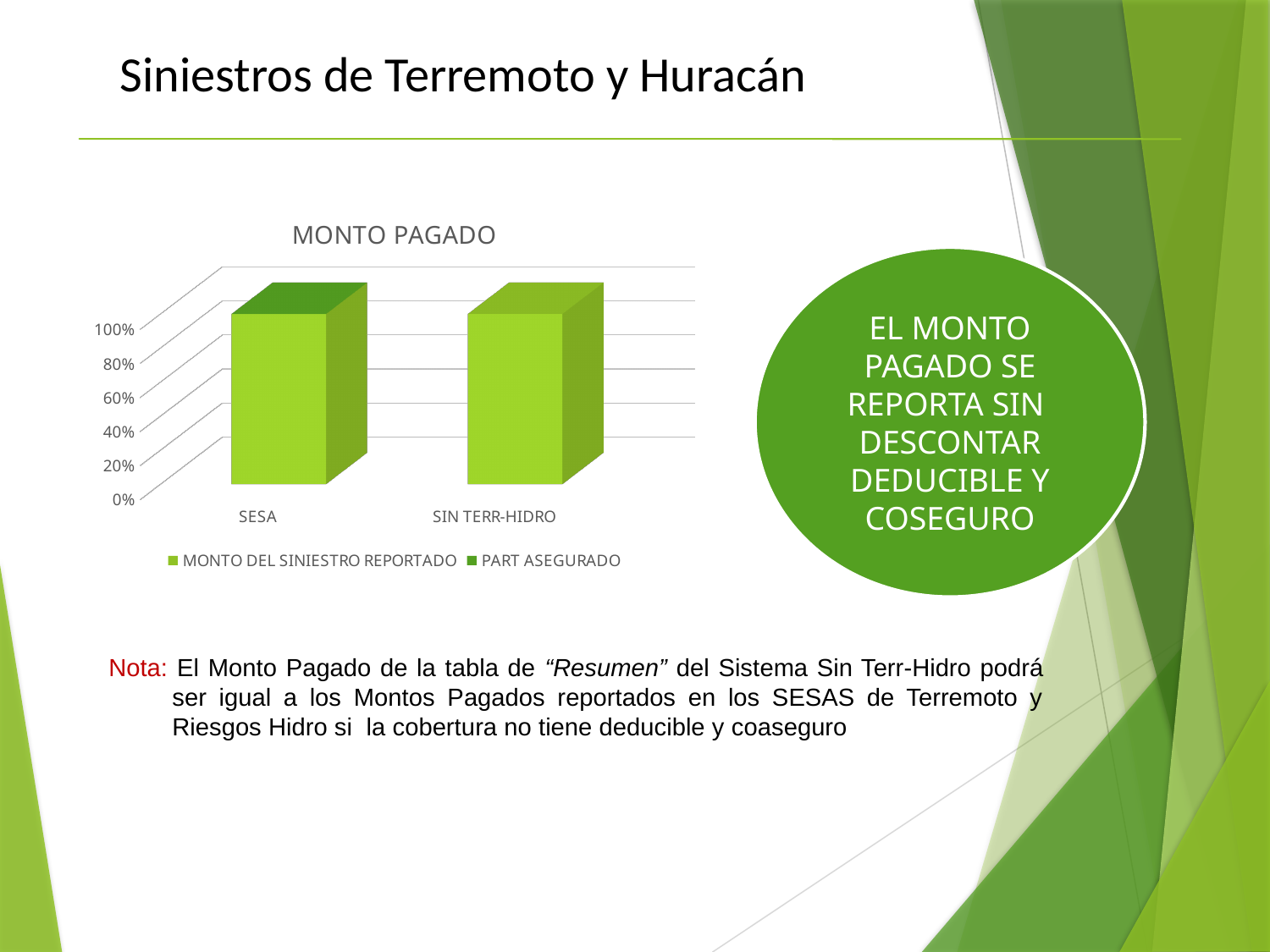
What kind of chart is shown on the slide? bar chart What is the title of the chart? MONTO PAGADO How many categories are shown on the x axis of the chart? 2 What is the lowest tick label shown on the y axis of the chart? 0% How many series does the chart legend list? 2 Is the value of the bar for SIN TERR-HIDRO greater or less than 60%? greater What are the two categories shown on the x axis of the chart? SESA and SIN TERR-HIDRO Is the value of the bar for SESA greater or less than 40%? greater What is the highest tick label shown on the y axis of the chart? 100% Is the value of the bar for SESA greater or less than 80%? greater